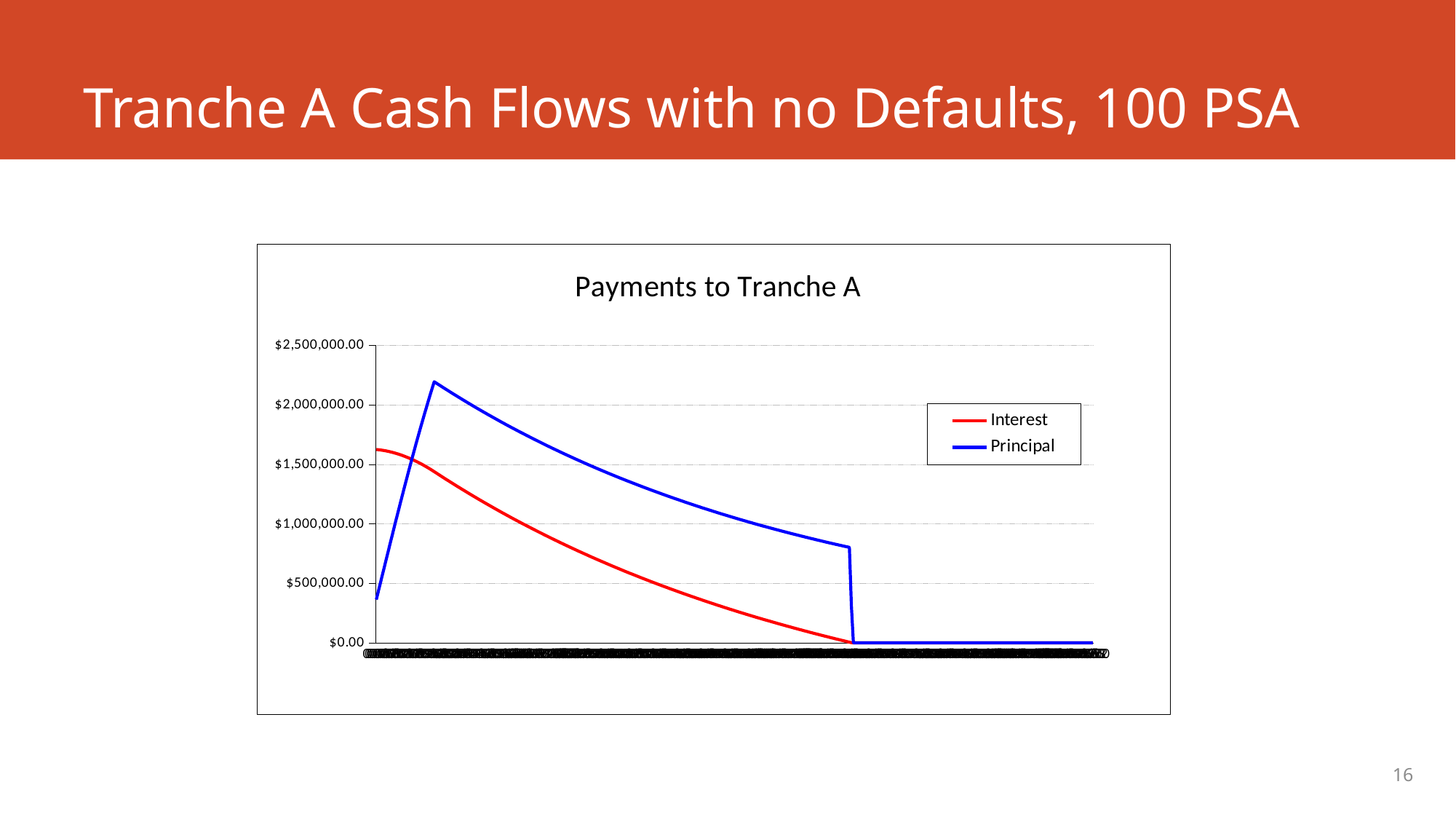
Which series has the highest value plotted anywhere on the chart? Principal Is the highest value of the Interest series greater or less than $2,000,000.00? less Is the peak value of the Principal series greater or less than $2,000,000.00? greater What kind of chart is shown on the slide? line chart What is the highest value shown on the y axis of the chart? $2,500,000.00 Which series reaches the higher peak value in the chart, Interest or Principal? Principal What is the title of the chart? Payments to Tranche A Which colour is used for the Principal series in the chart? blue How many series does the legend of the chart list? 2 Is the first plotted value of the Principal series greater or less than $500,000.00? less Does the Interest series rise or fall along the x axis? fall